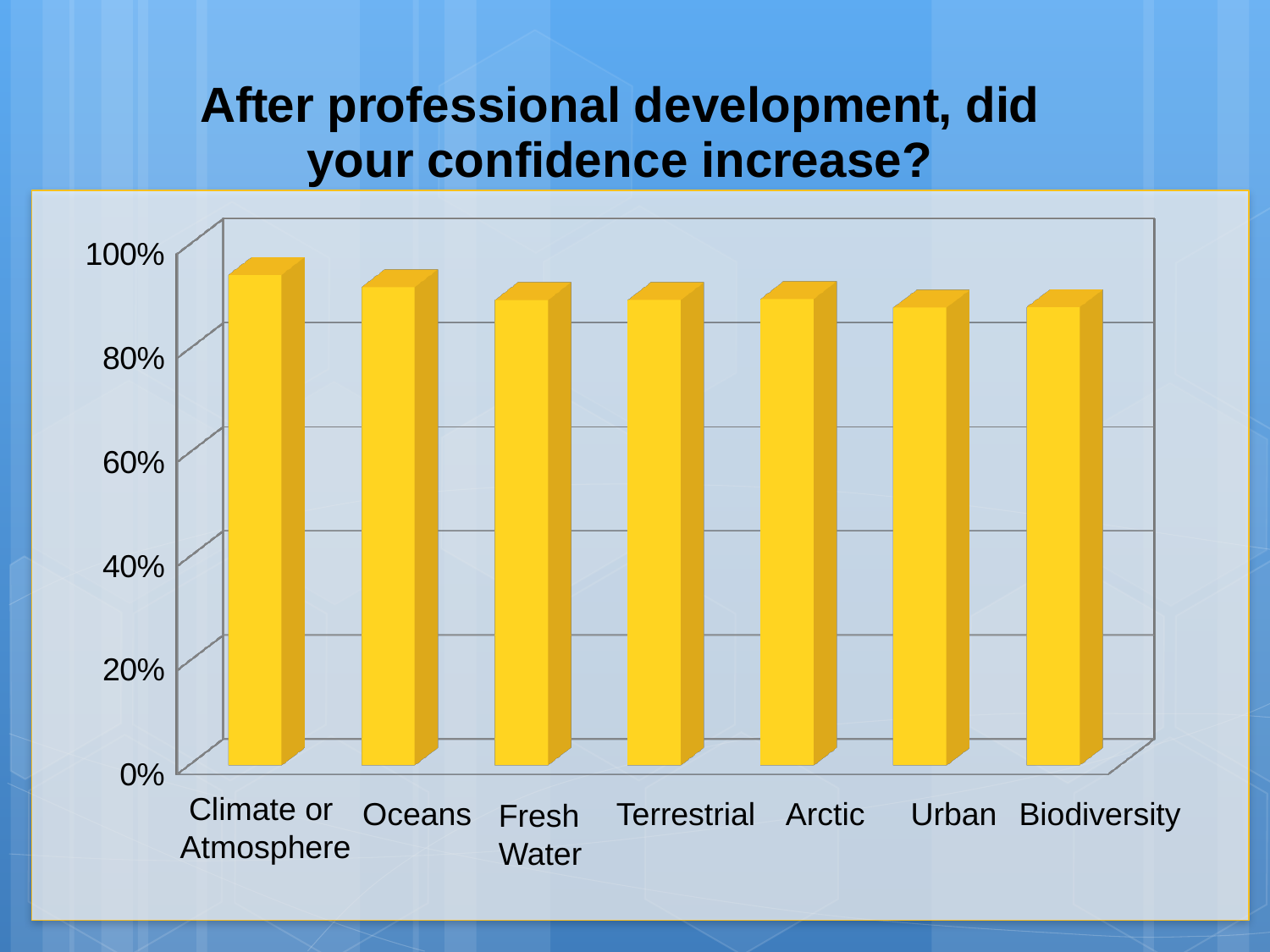
Is the value for Arctic greater or less than 60%? greater Do the bar values generally rise or fall from left to right across the categories? fall Which is larger, the value for Oceans or the value for Urban? Oceans Which category has the highest bar in the chart? Climate or Atmosphere What is the title of the slide above the chart? After professional development, did your confidence increase? Is the value for Climate or Atmosphere greater or less than 80%? greater Is the value for Urban greater or less than 80%? greater How many categories are shown on the x axis of the chart? 7 Which is larger, the value for Climate or Atmosphere or the value for Biodiversity? Climate or Atmosphere What kind of chart is shown on the slide? bar chart What is the highest value labelled on the vertical axis of the chart? 100%